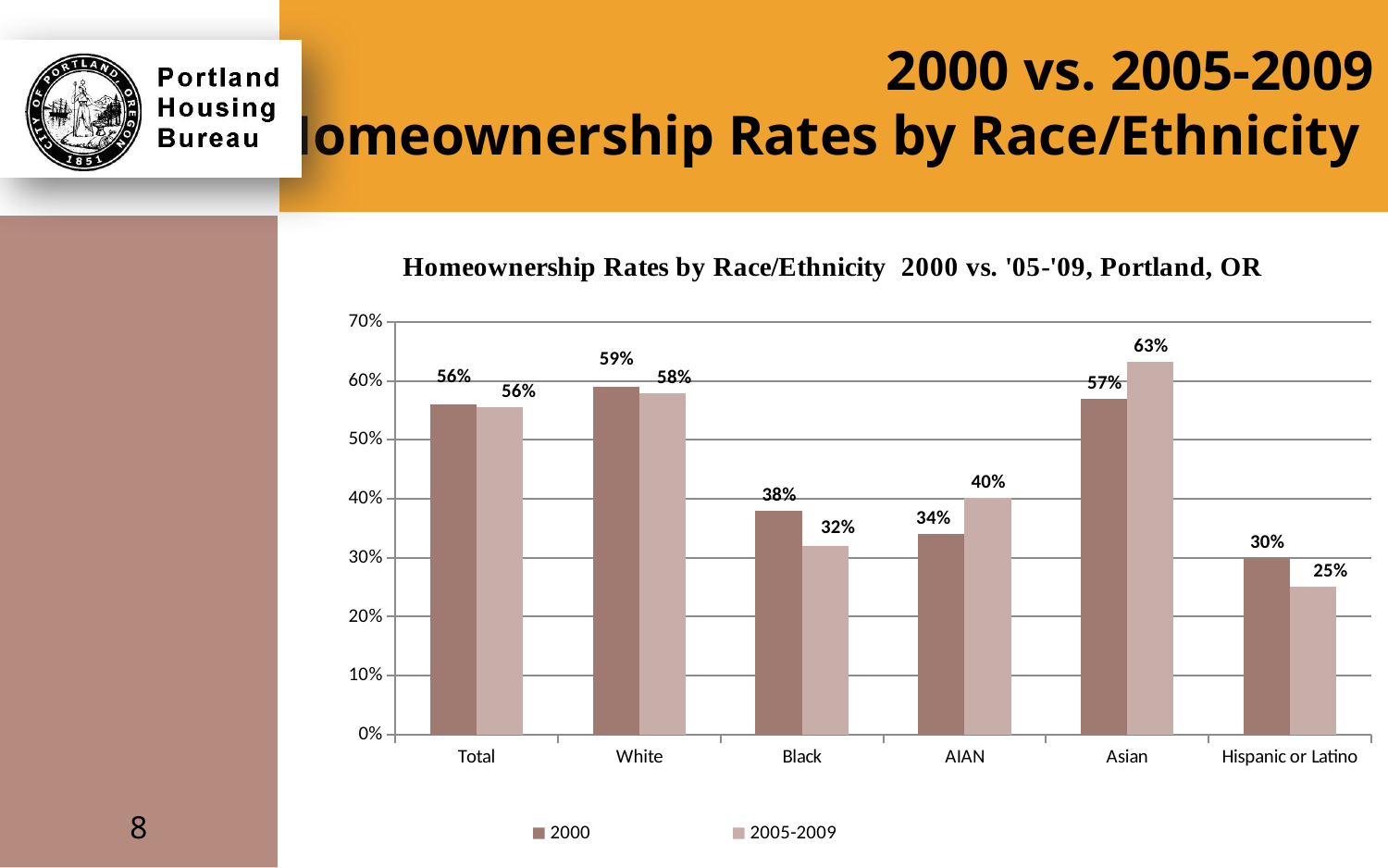
What are the two series named in the legend? 2000 and 2005-2009 What kind of chart is shown on the slide? Bar chart Which is larger for AIAN residents: the 2000 rate or the 2005-2009 rate? 2005-2009 Is the 2005-2009 homeownership rate for White residents greater or less than 50%? greater What is the difference between the 2000 and 2005-2009 homeownership rates for Black residents? 6% Which race/ethnicity category has the lowest homeownership rate in 2000? Hispanic or Latino What is the homeownership rate for Hispanic or Latino residents in 2005-2009? 25% What is the homeownership rate for Black residents in 2000? 38% Which race/ethnicity category has the highest homeownership rate in 2005-2009? Asian How many series does the legend list? 2 How many race/ethnicity categories are shown on the x axis? 6 What is the homeownership rate for Asian residents in 2005-2009? 63%